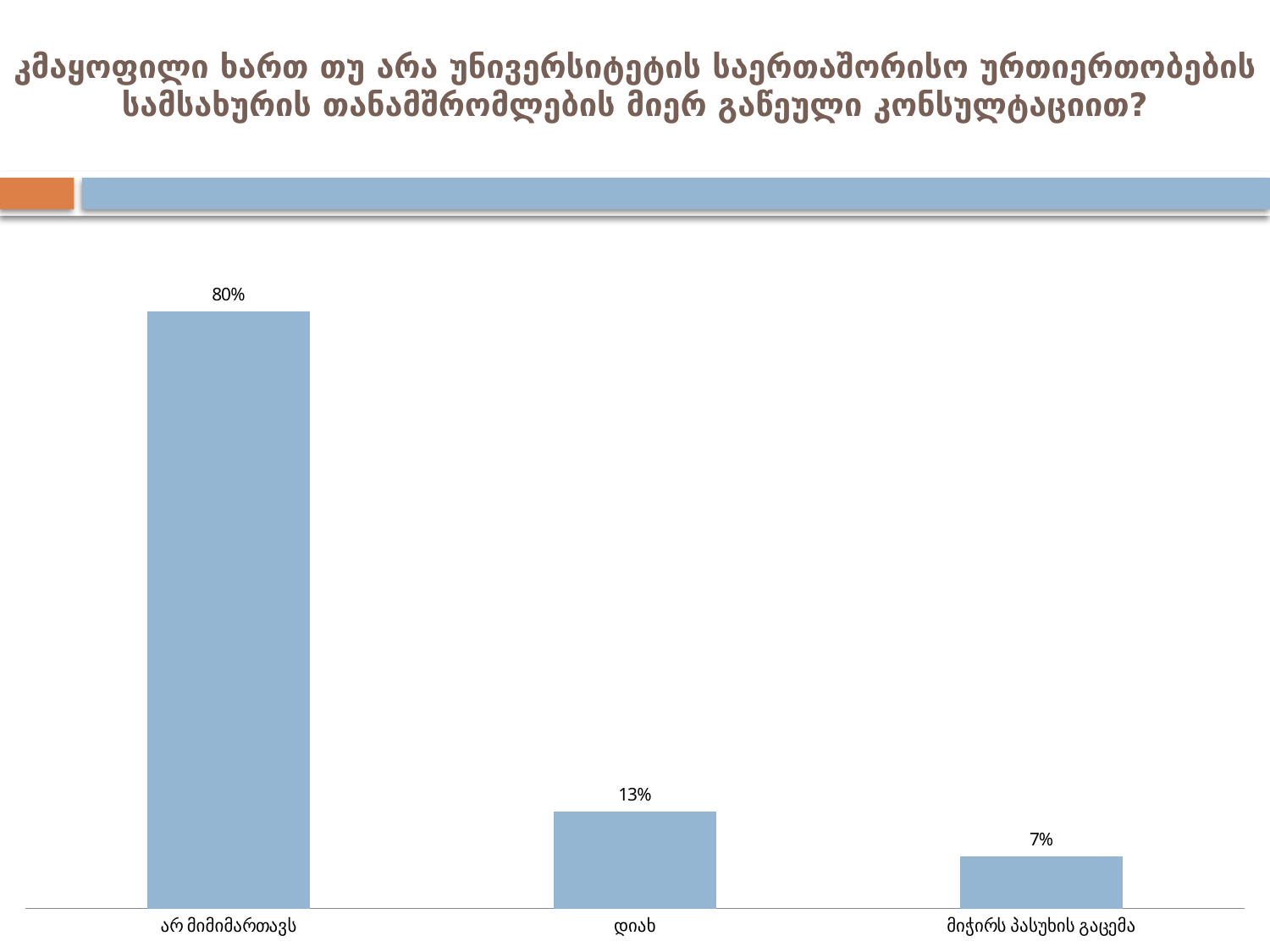
What kind of chart is shown on the slide? bar chart What is the value for "მიჭირს პასუხის გაცემა"? 7% Which is larger, the value for "დიახ" or the value for "მიჭირს პასუხის გაცემა"? დიახ What is the value for "დიახ"? 13% Which category has the highest value? არ მიმიმართავს Do the values rise or fall from left to right across the categories? fall What is the difference between the values for "არ მიმიმართავს" and "დიახ"? 67% How many categories are shown in the chart? 3 What is the value for "არ მიმიმართავს"? 80% Which category has the lowest value? მიჭირს პასუხის გაცემა What is the difference between the values for "დიახ" and "მიჭირს პასუხის გაცემა"? 6% What colour are the bars in the chart? light blue